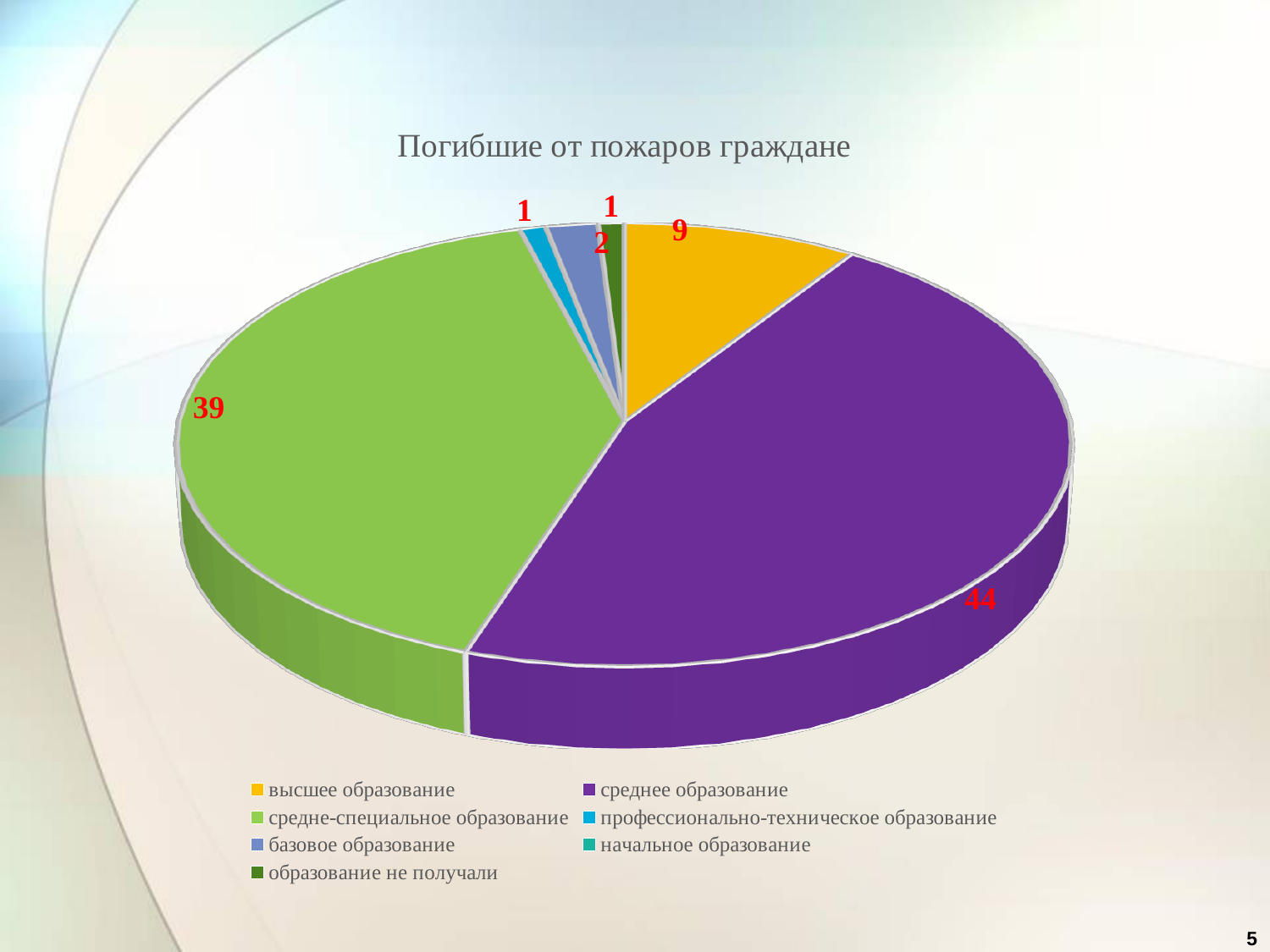
Which is larger, the value for высшее образование or the value for базовое образование? высшее образование What is the difference between the values for средне-специальное образование and высшее образование? 30 What kind of chart is shown on the slide? pie chart What is the difference between the values for среднее образование and средне-специальное образование? 5 Which category has the largest slice of the pie? среднее образование How many entries does the legend list? 7 What is the value for высшее образование? 9 What is the value for средне-специальное образование? 39 What colour is the slice for среднее образование? purple What is the value for среднее образование? 44 What is the value for базовое образование? 2 What is the title of the chart? Погибшие от пожаров граждане